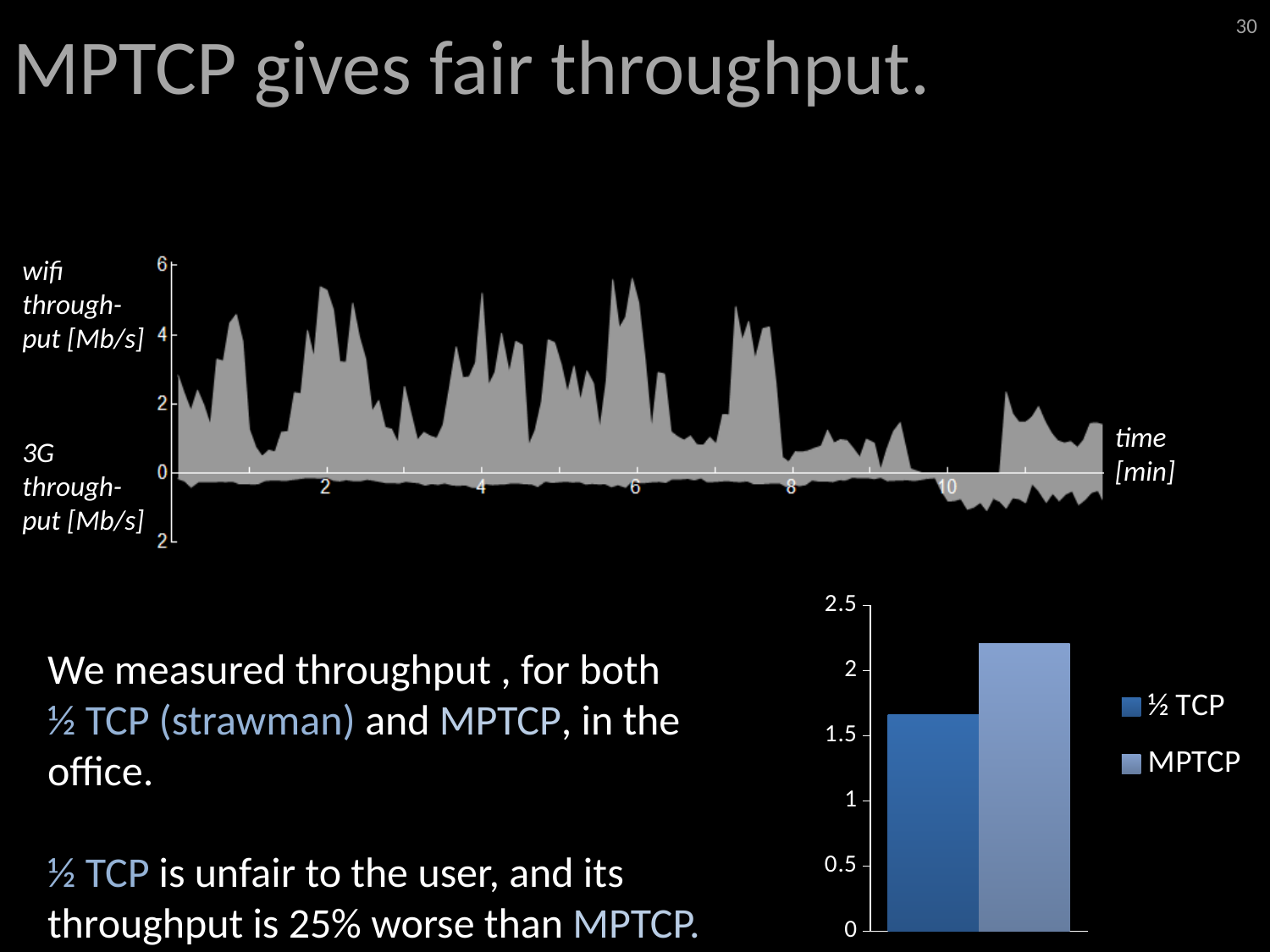
In the top chart, what unit is used for the time axis? min In the bar chart at the bottom right, is the value for MPTCP greater or less than 2? greater In the bar chart at the bottom right, is the value for MPTCP greater or less than 2.5? less How many bars are plotted in the bar chart at the bottom right? 2 What is the maximum value shown on the vertical axis of the bar chart at the bottom right? 2.5 What kind of chart is the chart at the bottom right of the slide? bar chart In the bar chart at the bottom right, which series has the lowest bar? ½ TCP In the bar chart at the bottom right, is the value for ½ TCP greater or less than 1.5? greater How many series does the legend of the bar chart at the bottom right list? 2 In the bar chart at the bottom right, which series has the taller bar, ½ TCP or MPTCP? MPTCP What are the two legend entries of the bar chart at the bottom right? ½ TCP and MPTCP